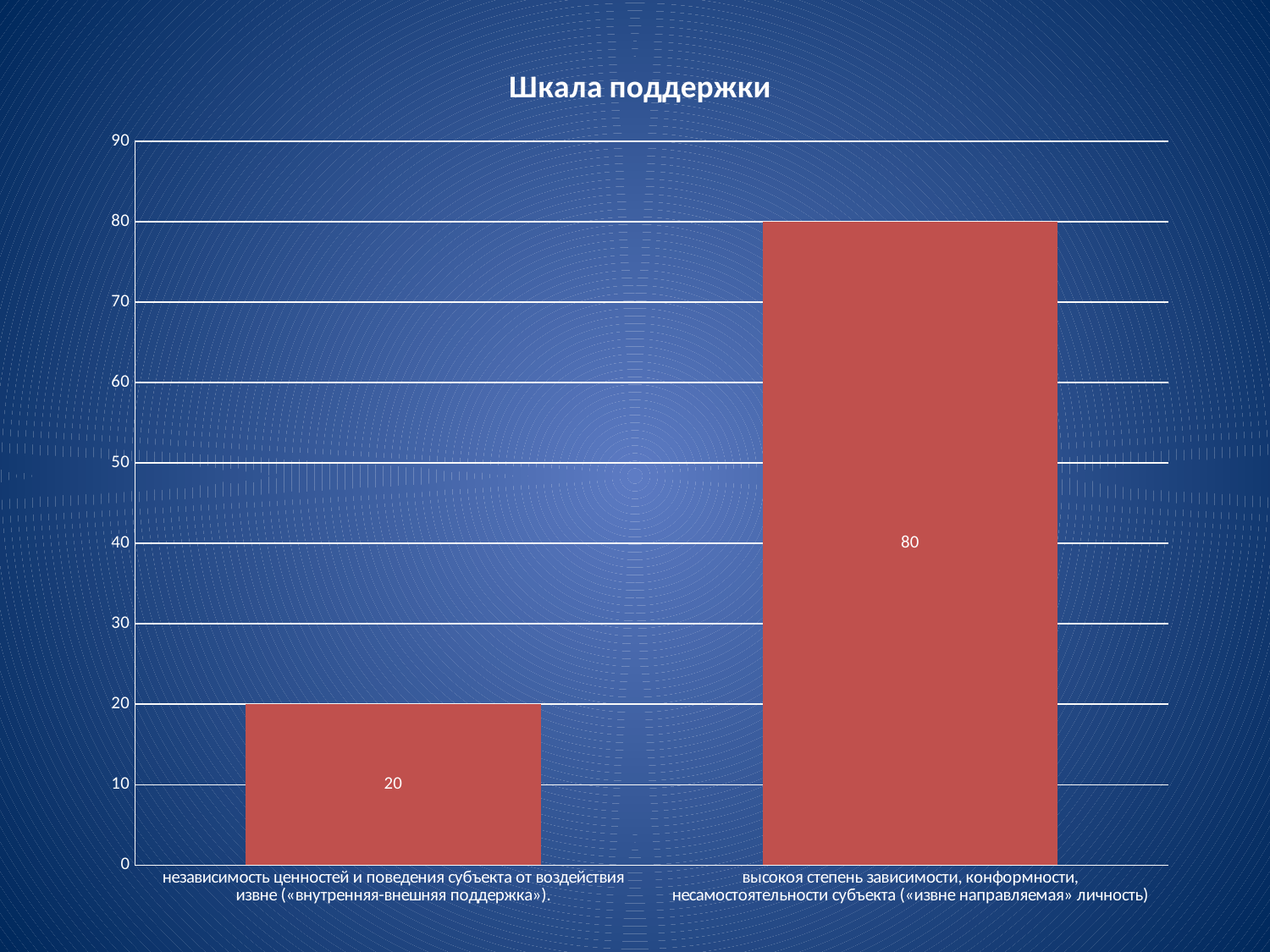
What is the title of the chart? Шкала поддержки How many categories are plotted in the chart? 2 What is the value for «высокоя степень зависимости, конформности, несамостоятельности субъекта («извне направляемая» личность)»? 80 What is the maximum value shown on the vertical axis? 90 Which category has the highest value? высокоя степень зависимости, конформности, несамостоятельности субъекта («извне направляемая» личность) What type of chart is shown on the slide? bar chart Is the value for «высокоя степень зависимости...» greater or less than 50? greater Which category has the lowest value? независимость ценностей и поведения субъекта от воздействия извне («внутренняя-внешняя поддержка»). Is the value for «независимость ценностей...» greater or less than 30? less Which is larger: the value for «независимость ценностей...» or the value for «высокоя степень зависимости...»? высокоя степень зависимости, конформности, несамостоятельности субъекта («извне направляемая» личность) What is the value for «независимость ценностей и поведения субъекта от воздействия извне («внутренняя-внешняя поддержка»)»? 20 What is the difference between the value for «высокоя степень зависимости...» and the value for «независимость ценностей...»? 60